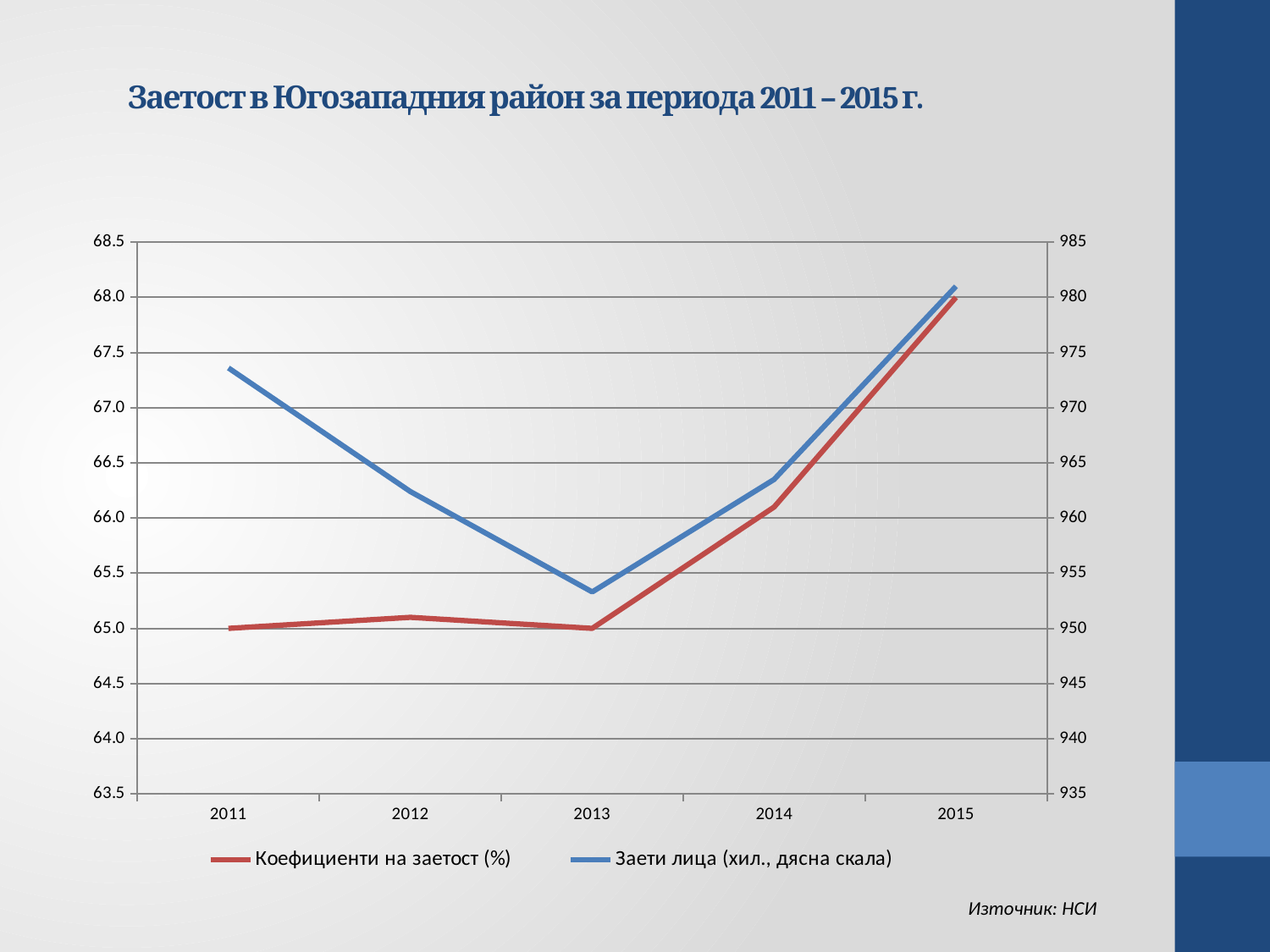
Is the value for 'Коефициенти на заетост (%)' in 2015 greater or less than 67.5? greater How many series does the legend list? 2 What kind of chart is shown on the slide? line chart Is the value for 'Заети лица (хил., дясна скала)' in 2013 greater or less than 955? less In which year is the value of 'Заети лица (хил., дясна скала)' highest? 2015 In which year is the value of 'Заети лица (хил., дясна скала)' lowest? 2013 How many years are plotted along the x axis? 5 What is the title of the chart? Заетост в Югозападния район за периода 2011 – 2015 г. Which is larger for 'Коефициенти на заетост (%)': the value in 2011 or the value in 2015? 2015 Is the value for 'Заети лица (хил., дясна скала)' in 2011 greater or less than 970? greater In which year is the value of 'Коефициенти на заетост (%)' highest? 2015 Does the 'Заети лица (хил., дясна скала)' line rise or fall from 2011 to 2013? fall